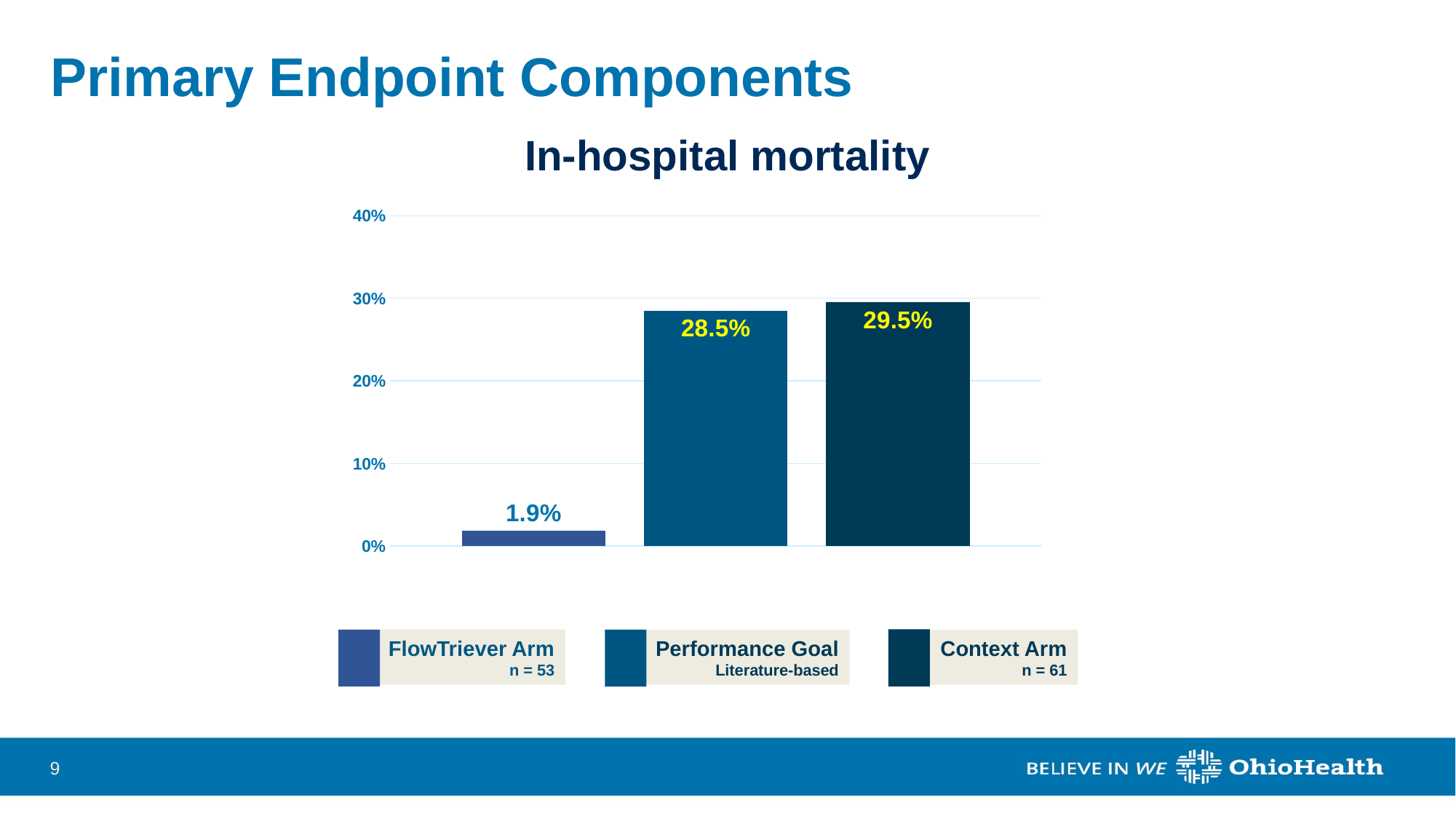
What is the sample size (n) shown in the legend for the Context Arm? n = 61 What is the in-hospital mortality value for the Context Arm? 29.5% Is the in-hospital mortality for the Context Arm greater or less than 20%? greater Which has a higher in-hospital mortality, the FlowTriever Arm or the Performance Goal? Performance Goal What is the difference in in-hospital mortality between the Performance Goal and the FlowTriever Arm? 26.6% What is the in-hospital mortality value for the FlowTriever Arm? 1.9% What is the difference in in-hospital mortality between the Context Arm and the FlowTriever Arm? 27.6% How many bars are shown in the in-hospital mortality chart? 3 What type of chart is used to show in-hospital mortality? Bar chart Which bar shows the lowest in-hospital mortality? FlowTriever Arm What is the in-hospital mortality value for the Performance Goal? 28.5% Which bar shows the highest in-hospital mortality? Context Arm